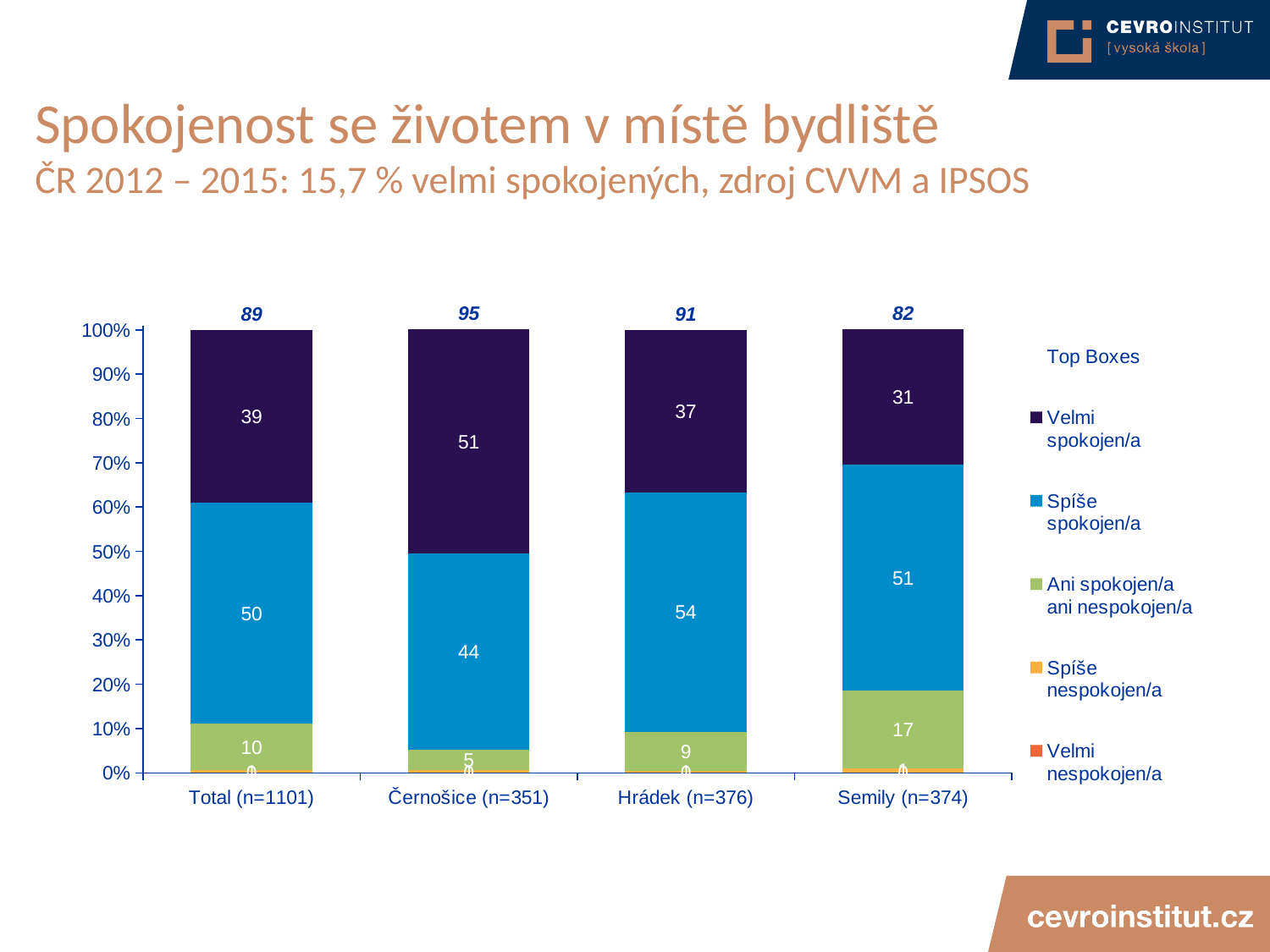
Which category has the lowest value for 'Velmi spokojen/a'? Semily (n=374) How many categories are shown on the x axis of the chart? 4 Which is larger: the 'Spíše spokojen/a' value for Hrádek (n=376) or for Černošice (n=351)? Hrádek (n=376) What is the value of 'Spíše spokojen/a' for Hrádek (n=376)? 54 What is the Top Boxes value shown above the bar for Total (n=1101)? 89 What is the value of 'Velmi spokojen/a' for Černošice (n=351)? 51 How many series does the chart legend list? 6 What is the value of 'Ani spokojen/a ani nespokojen/a' for Semily (n=374)? 17 What is the title of the slide containing the chart? Spokojenost se životem v místě bydliště Which category has the highest Top Boxes value? Černošice (n=351) What is the difference between the Top Boxes values for Černošice (n=351) and Semily (n=374)? 13 What kind of chart is shown on the slide? stacked bar chart